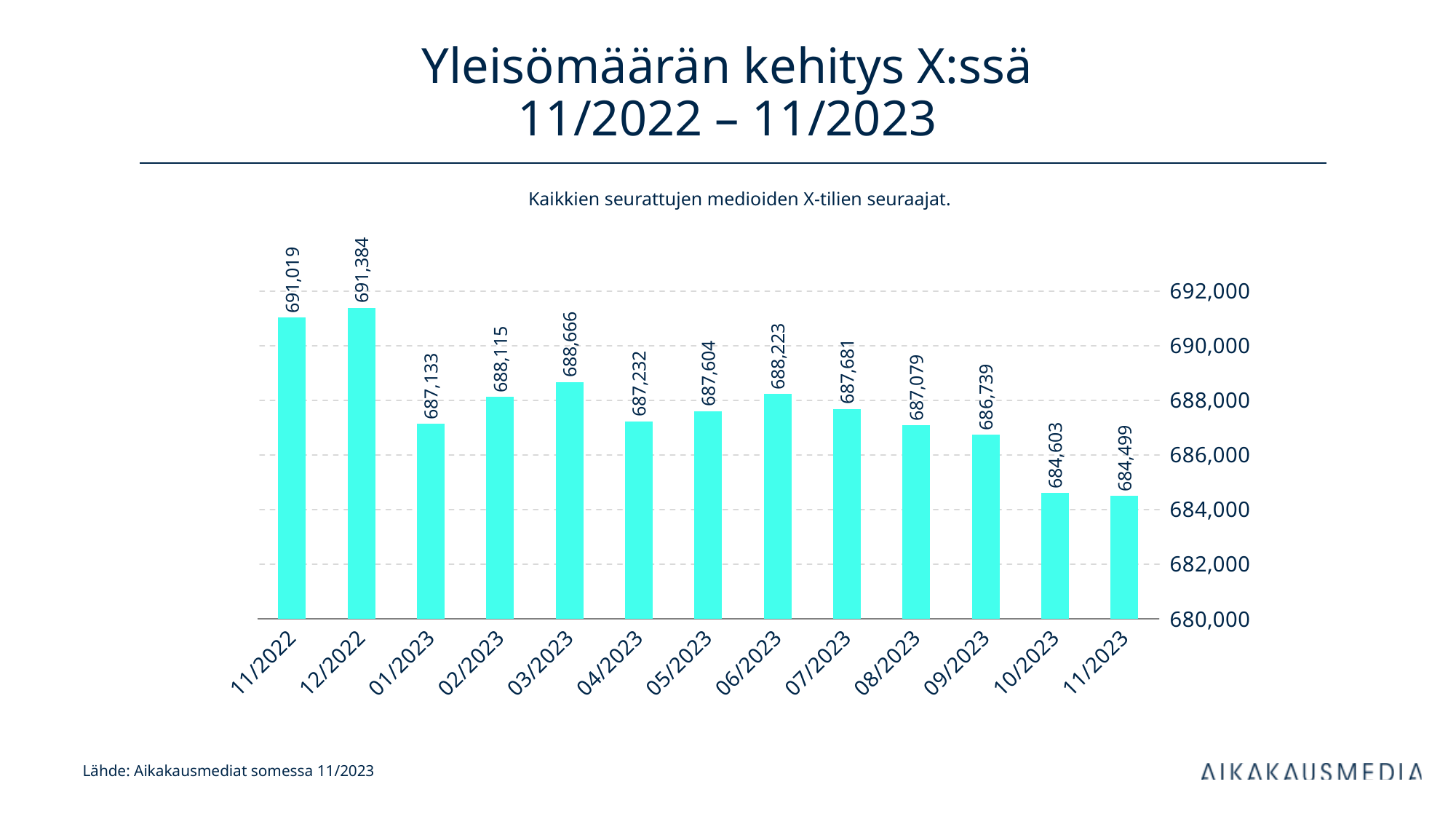
How many months are shown on the x axis? 13 What is the difference between the values for 12/2022 and 11/2022? 365 What is the value for 03/2023? 688,666 What is the value for 11/2022? 691,019 Do the values generally rise or fall from 11/2022 to 11/2023? fall What is the value for 11/2023? 684,499 What kind of chart is shown on the slide? bar chart What is the difference between the values for 11/2022 and 11/2023? 6,520 Which month has the lowest value? 11/2023 Which is larger, the value for 02/2023 or the value for 04/2023? 02/2023 Which month has the highest value? 12/2022 Is the value for 10/2023 greater or less than 686,000? less